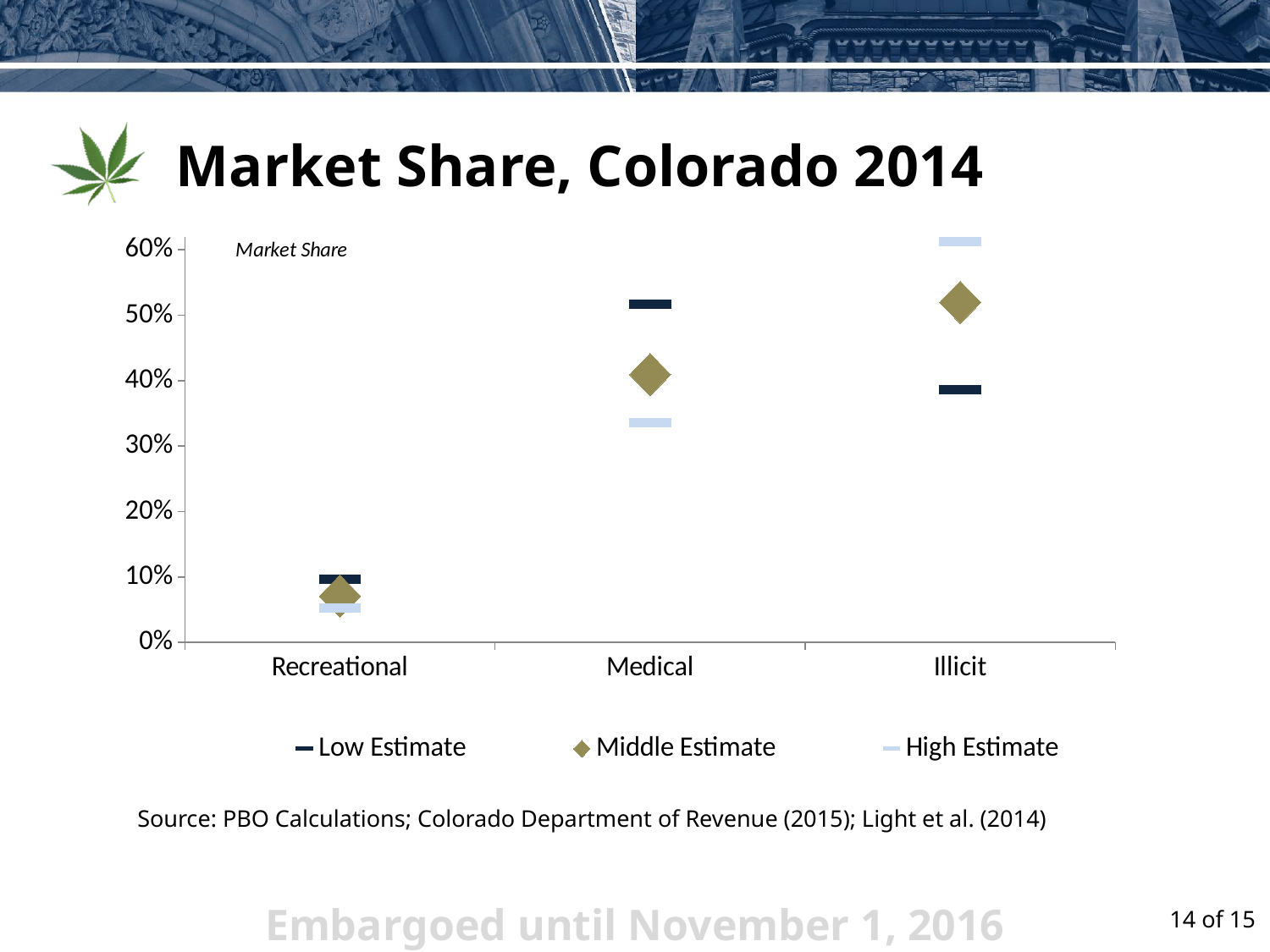
Which category has the lowest Middle Estimate? Recreational How many categories are shown on the x axis? 3 Is the Middle Estimate for Recreational greater or less than 10%? less Which series is shown with diamond markers? Middle Estimate What is the title of the chart? Market Share, Colorado 2014 Which category has the highest Middle Estimate? Illicit Is the Low Estimate for Illicit greater or less than 40%? less Is the High Estimate for Illicit greater or less than 60%? greater Which is larger, the Middle Estimate for Medical or the Middle Estimate for Illicit? Illicit How many series does the legend list? 3 What kind of chart is shown on the slide? scatter chart